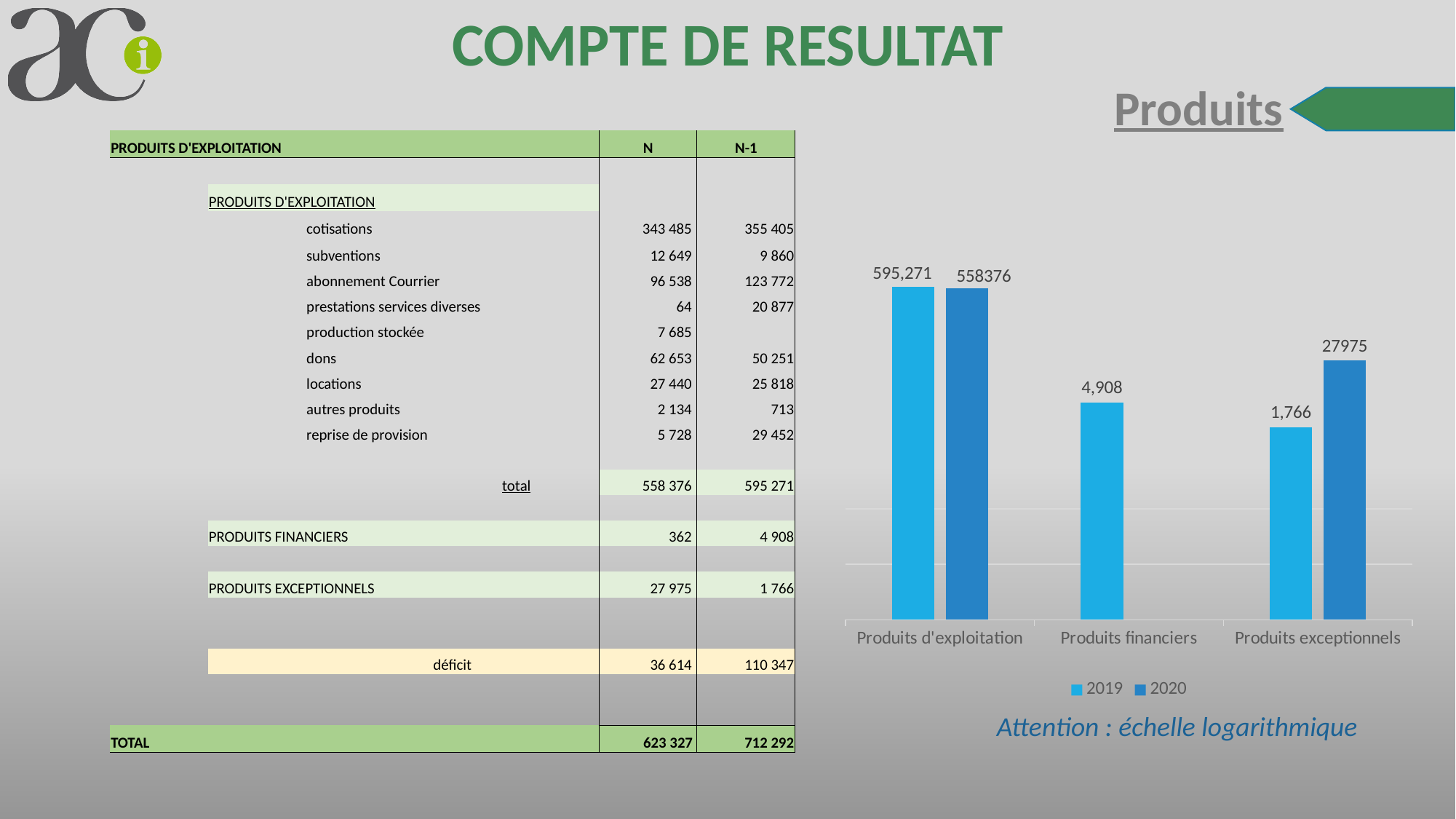
For Produits exceptionnels, is the 2019 or the 2020 value larger? 2020 What is the 2020 value for Produits exceptionnels in the chart? 27975 What is the 2019 value for Produits financiers in the chart? 4,908 How many series does the chart legend list? 2 What is the 2020 value for Produits d'exploitation in the chart? 558376 Which category has the highest 2020 value in the chart? Produits d'exploitation What is the 2019 value for Produits exceptionnels in the chart? 1,766 What is the difference between the 2019 and 2020 values for Produits exceptionnels? 26,209 How many categories are shown on the x axis of the chart? 3 What kind of chart is shown on the right of the slide? bar chart Which category has the lowest 2019 value in the chart? Produits exceptionnels What is the 2019 value for Produits d'exploitation in the chart? 595,271